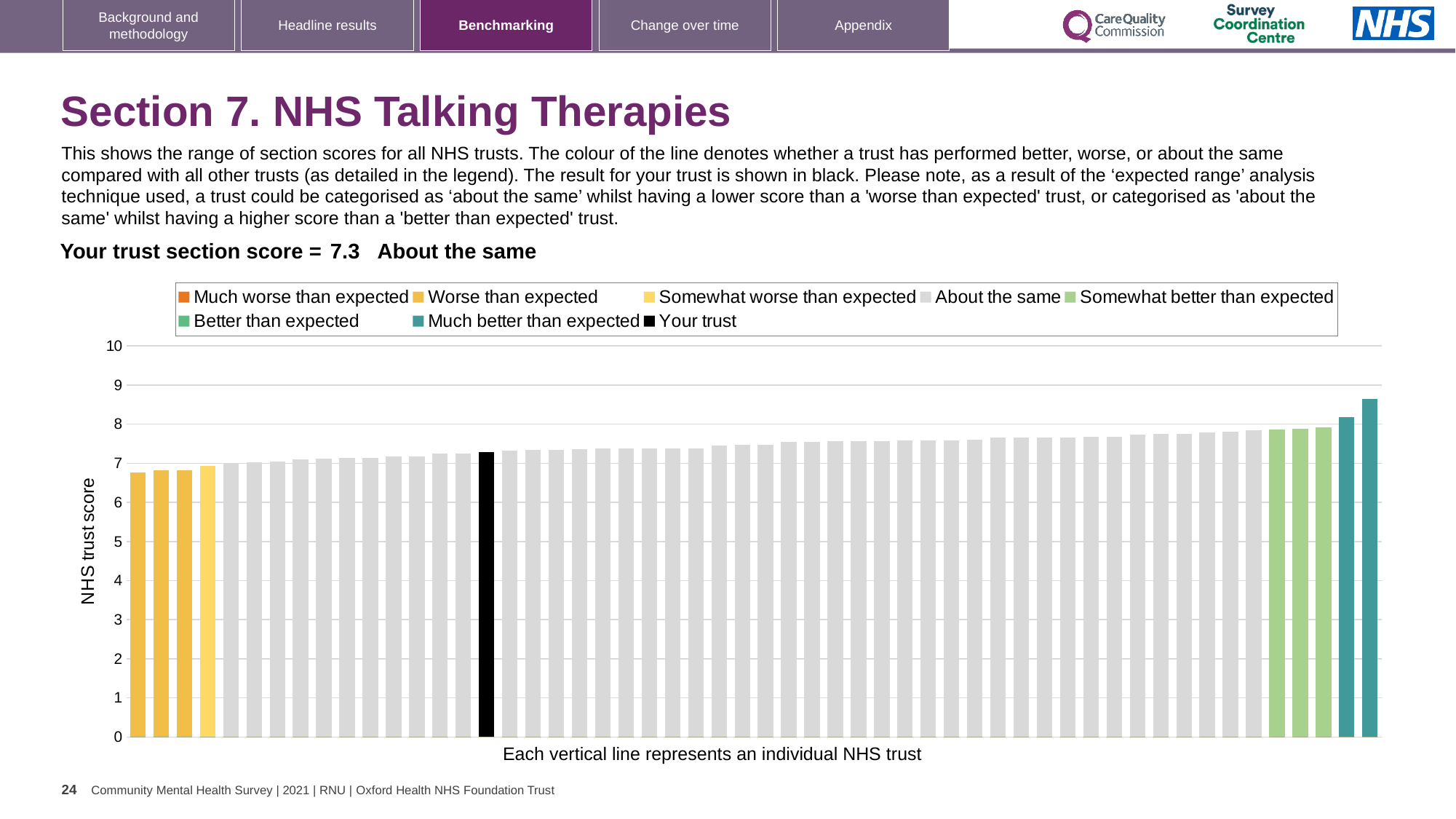
What kind of chart is shown on the slide? bar chart What is the section score for your trust shown on the slide? 7.3 How many entries does the chart legend list? 8 How many bars are coloured as 'Much better than expected' (teal)? 2 How many bars are coloured as 'Somewhat better than expected' (light green)? 3 Is the value for your trust (the black bar) greater or less than 7? greater Is the value of the tallest bar greater or less than 8? greater Do the bar values rise or fall from left to right along the x axis? rise What category is your trust placed in according to the text above the chart? About the same Is the value of the shortest bar greater or less than 7? less What is the title of the y axis? NHS trust score Which legend category does the tallest bar belong to? Much better than expected